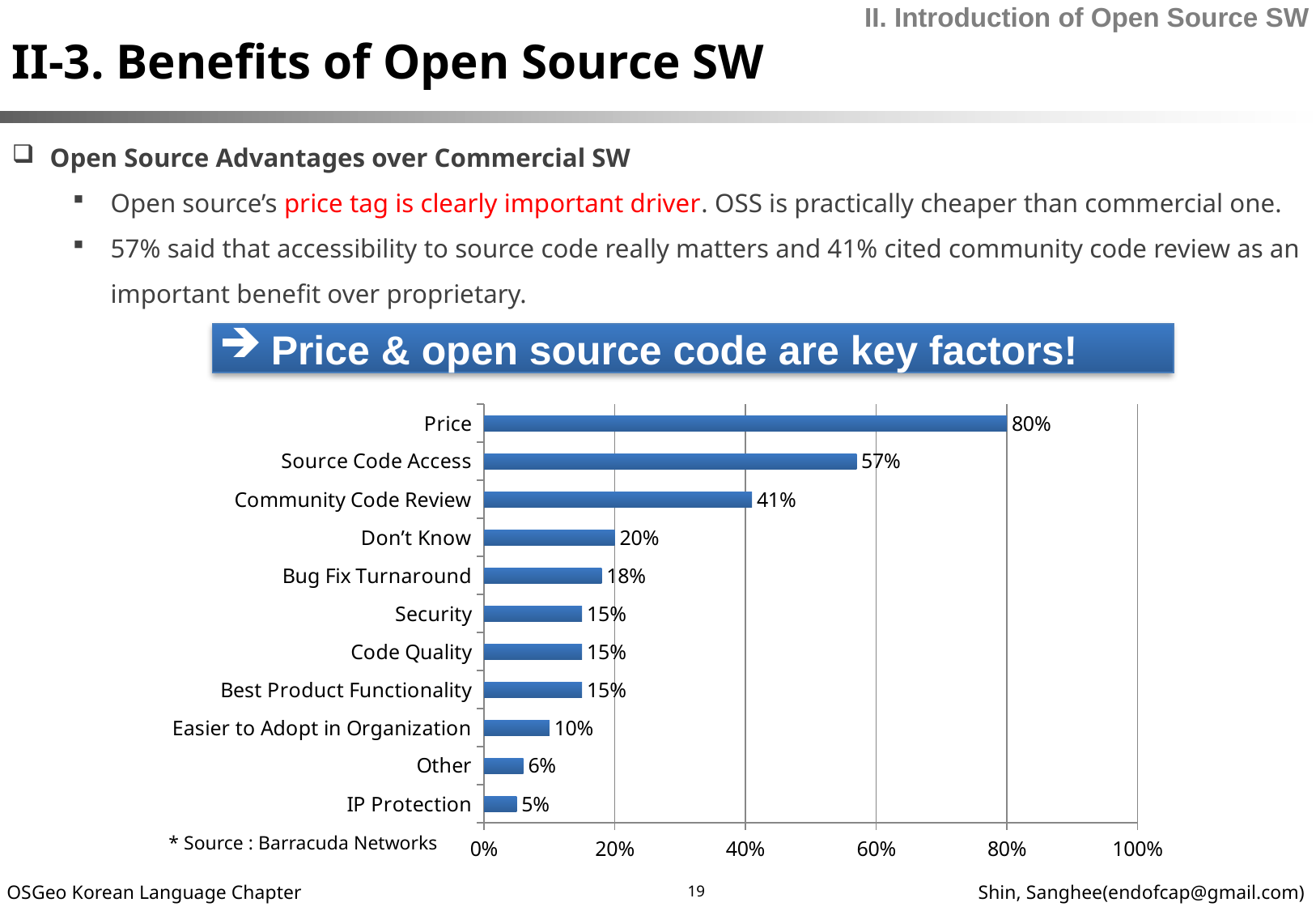
What is the value for Community Code Review? 41% What kind of chart is shown on the slide? bar chart Is the value for Community Code Review greater or less than 40%? greater What source is cited below the chart? Barracuda Networks What is the difference between the values for Don't Know and Bug Fix Turnaround? 2% Which category has the lowest value? IP Protection What is the value for Price? 80% Which is larger, the value for Source Code Access or the value for Community Code Review? Source Code Access Which category has the highest value? Price What is the difference between the values for Price and Source Code Access? 23% What is the value for Easier to Adopt in Organization? 10% How many categories are shown in the chart? 11